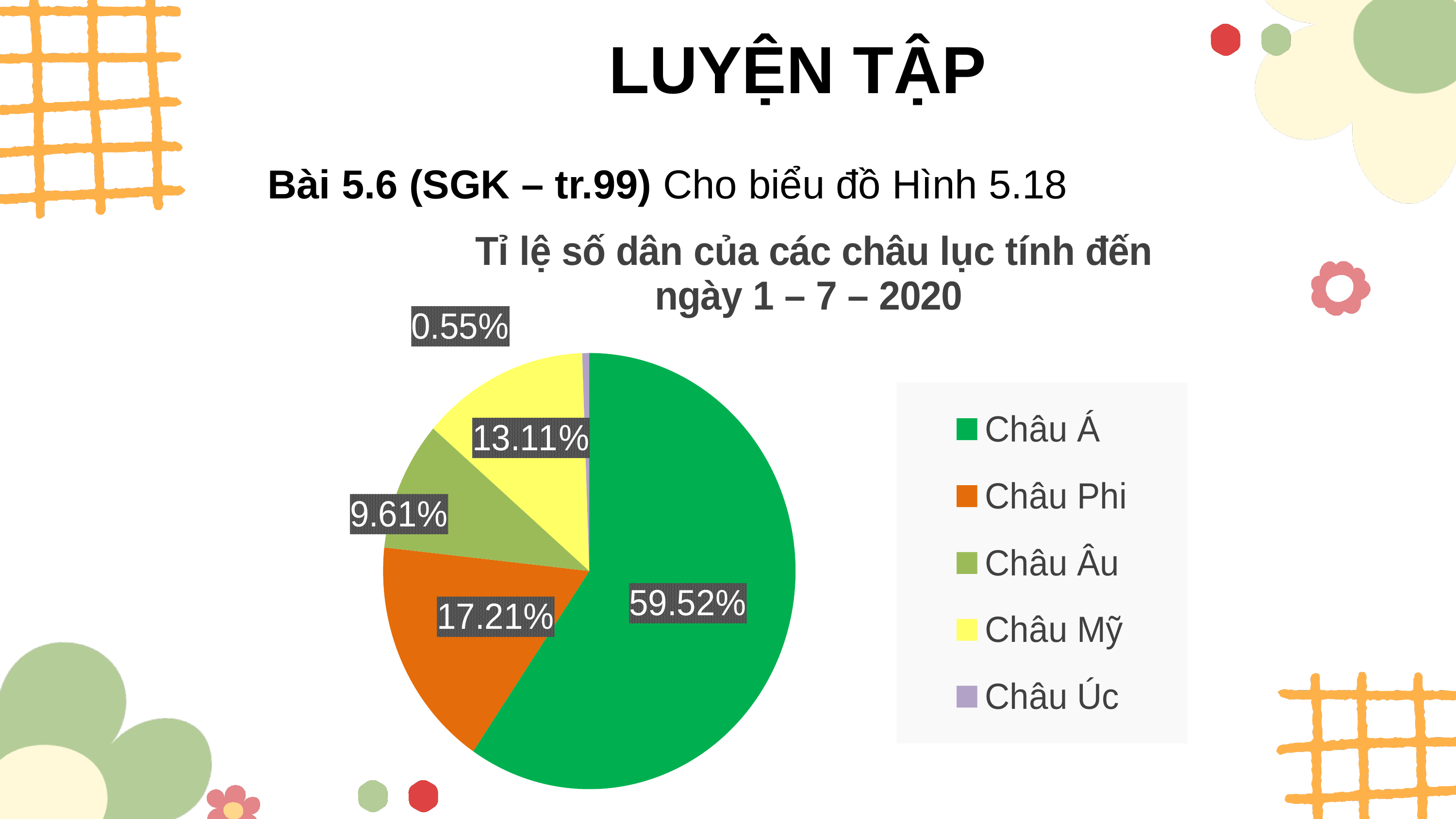
What kind of chart is shown on the slide? Pie chart What is the value shown for Châu Âu? 9.61% What is the difference between the values for Châu Phi and Châu Mỹ? 4.10% What is the title of the pie chart? Tỉ lệ số dân của các châu lục tính đến ngày 1 – 7 – 2020 Which continent has the largest share of the pie? Châu Á Which continent has the smallest share of the pie? Châu Úc What is the value shown for Châu Phi? 17.21% What is the value shown for Châu Mỹ? 13.11% What is the value shown for Châu Úc? 0.55% How many slices does the pie chart have? 5 Which is larger, the value for Châu Mỹ or the value for Châu Âu? Châu Mỹ What is the value shown for Châu Á? 59.52%